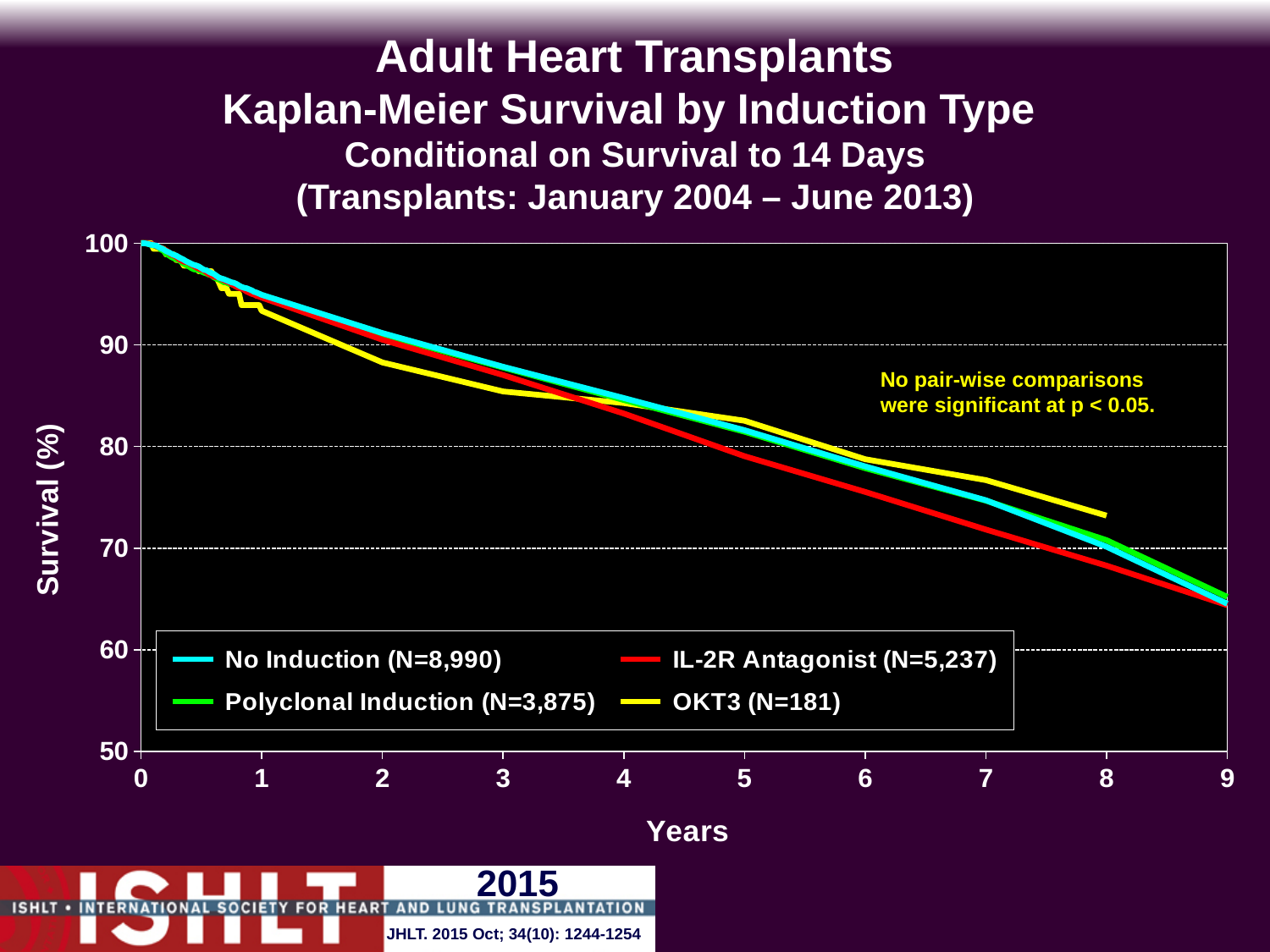
What is the N for the Polyclonal Induction group shown in the legend? N=3,875 How many series does the legend list? 4 At year 8, which series has the higher survival: OKT3 or IL-2R Antagonist? OKT3 Is the survival value for OKT3 at year 2 greater or less than 90? less Do the survival curves rise or fall as years increase? Fall Is the survival value for OKT3 at year 8 greater or less than 70? greater What is the N for the No Induction group shown in the legend? N=8,990 What kind of chart is shown on the slide? Line chart Is the survival value for IL-2R Antagonist at year 9 greater or less than 70? less What is the N for the IL-2R Antagonist group shown in the legend? N=5,237 What does the yellow annotation on the chart say about pair-wise comparisons? No pair-wise comparisons were significant at p < 0.05. What is the N for the OKT3 group shown in the legend? N=181